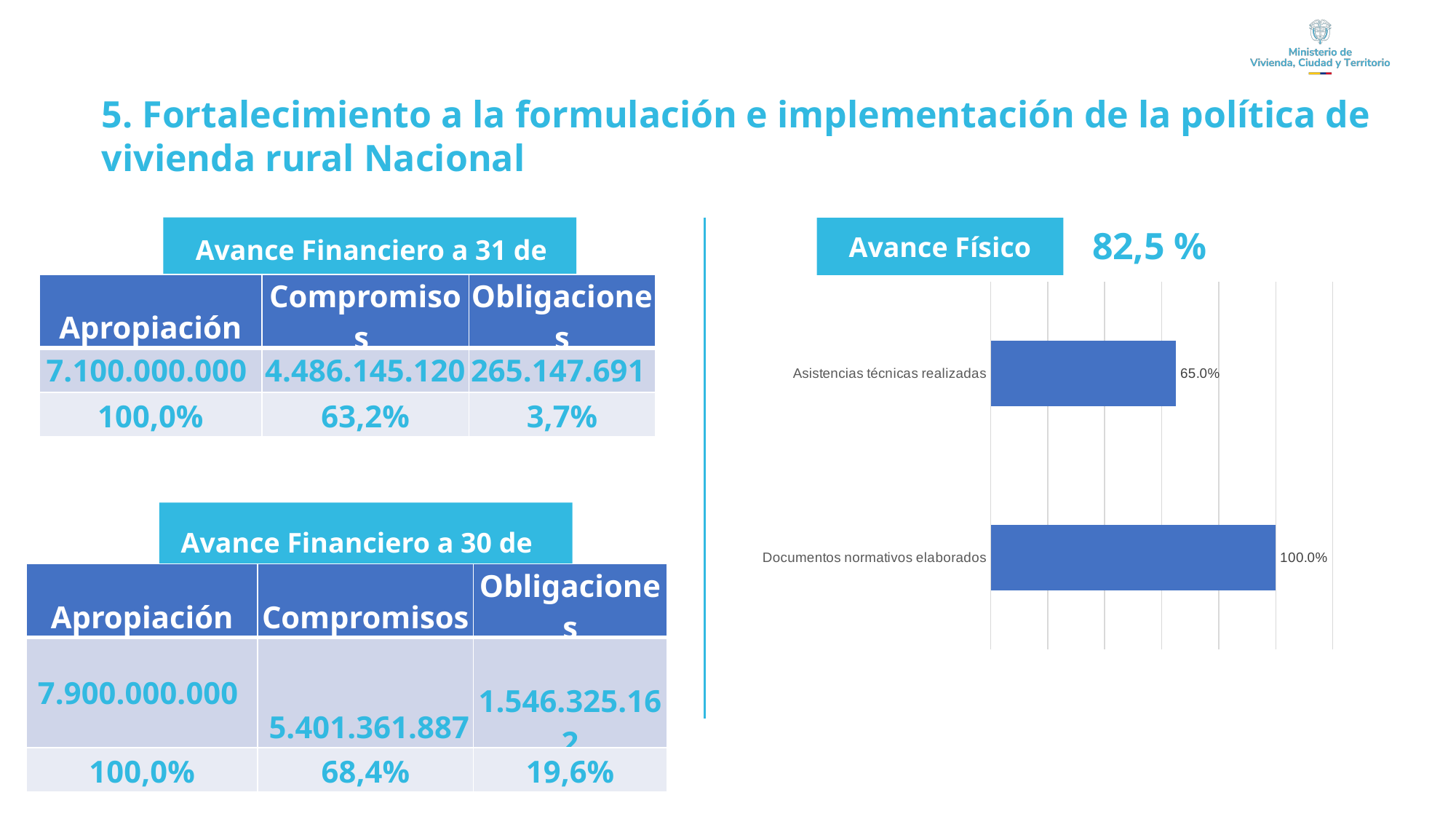
What is the heading shown above the bar chart? Avance Físico Which category has the lowest value in the bar chart? Asistencias técnicas realizadas How many categories are shown in the bar chart? 2 What is the difference between the values for Documentos normativos elaborados and Asistencias técnicas realizadas in the bar chart? 35.0% What overall percentage is displayed next to the Avance Físico heading above the bar chart? 82,5 % Which is larger in the bar chart: Asistencias técnicas realizadas or Documentos normativos elaborados? Documentos normativos elaborados What is the value for Asistencias técnicas realizadas in the bar chart? 65.0% What kind of chart is shown on the right side of the slide? Bar chart What is the value for Documentos normativos elaborados in the bar chart? 100.0% Which category has the highest value in the bar chart? Documentos normativos elaborados